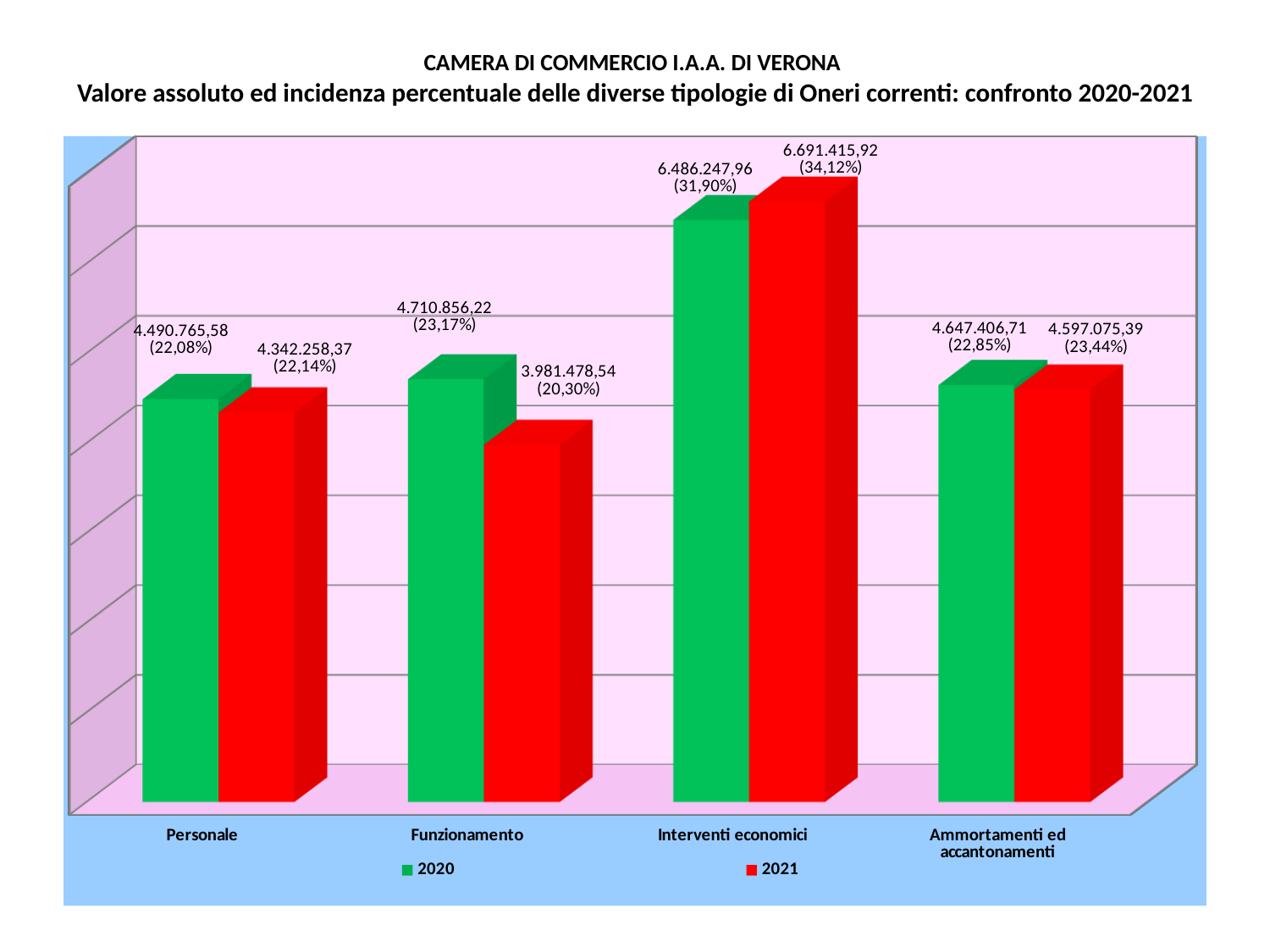
What is the value for Funzionamento in 2021? 3.981.478,54 Which category has the highest value in 2021? Interventi economici What is the difference between the 2021 and 2020 values for Interventi economici? 205.167,96 For Personale, which year has the larger value, 2020 or 2021? 2020 Which category has the lowest value in 2021? Funzionamento Which category has the lowest value in 2020? Personale What percentage share is shown for Interventi economici in 2021? 34,12% What is the value for Ammortamenti ed accantonamenti in 2020? 4.647.406,71 How many categories are shown on the x axis? 4 How many series does the legend list? 2 What is the value for Personale in 2020? 4.490.765,58 What is the difference between the 2020 and 2021 values for Funzionamento? 729.377,68